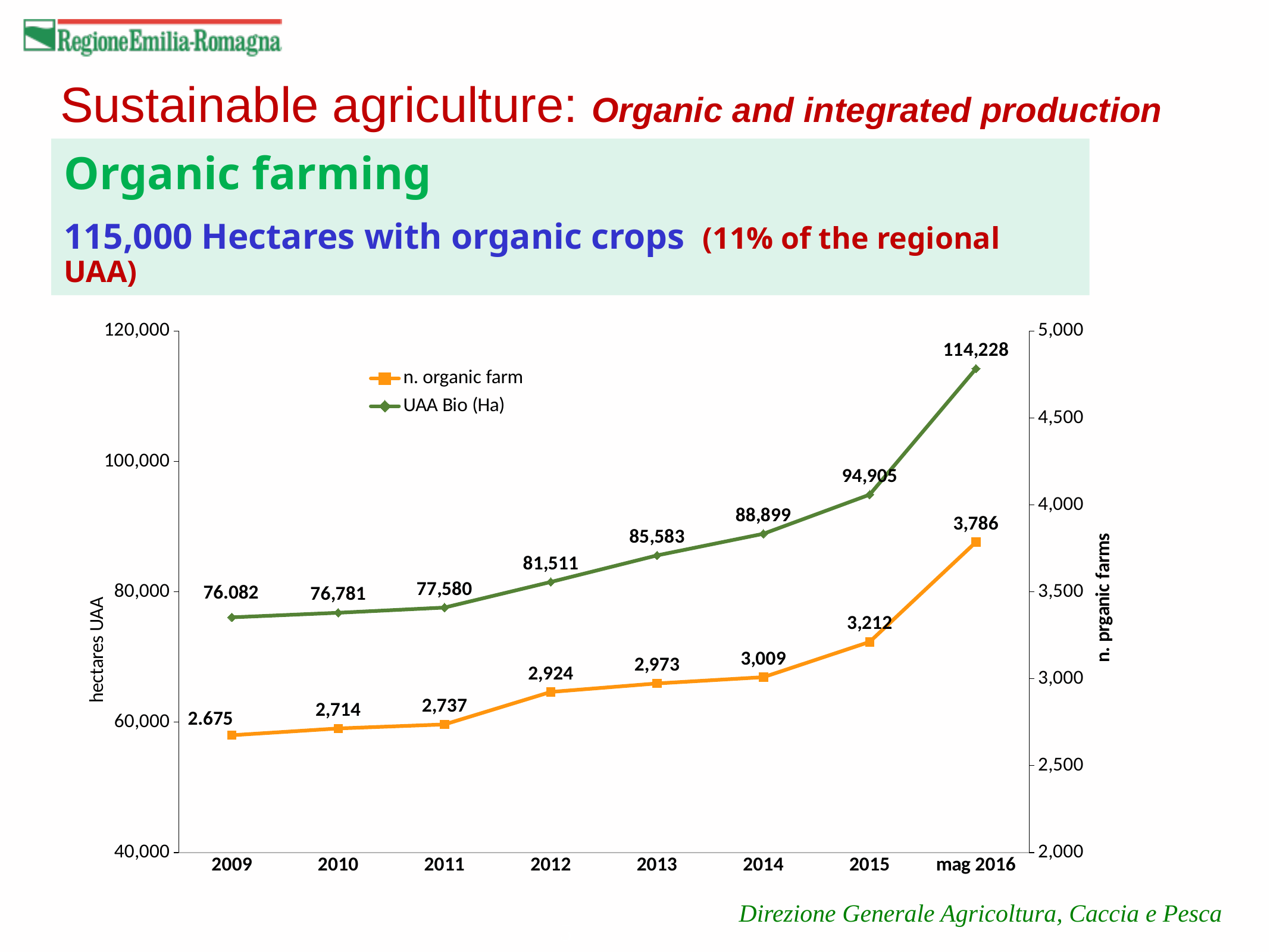
What is the value of n. organic farm in 2015? 3,212 What kind of chart is shown on the slide? Line chart What is the value of UAA Bio (Ha) in 2013? 85,583 Which is larger for UAA Bio (Ha): the value in 2014 or the value in 2012? 2014 What is the value of n. organic farm in 2012? 2,924 In which year is the n. organic farm series at its lowest? 2009 How many series does the legend list? 2 What is the difference between the UAA Bio (Ha) values at mag 2016 and 2015? 19,323 How many time points are plotted on the x axis? 8 What is the difference between the n. organic farm values at mag 2016 and 2015? 574 In which year does the UAA Bio (Ha) series reach its highest value? mag 2016 What is the value of UAA Bio (Ha) at mag 2016? 114,228